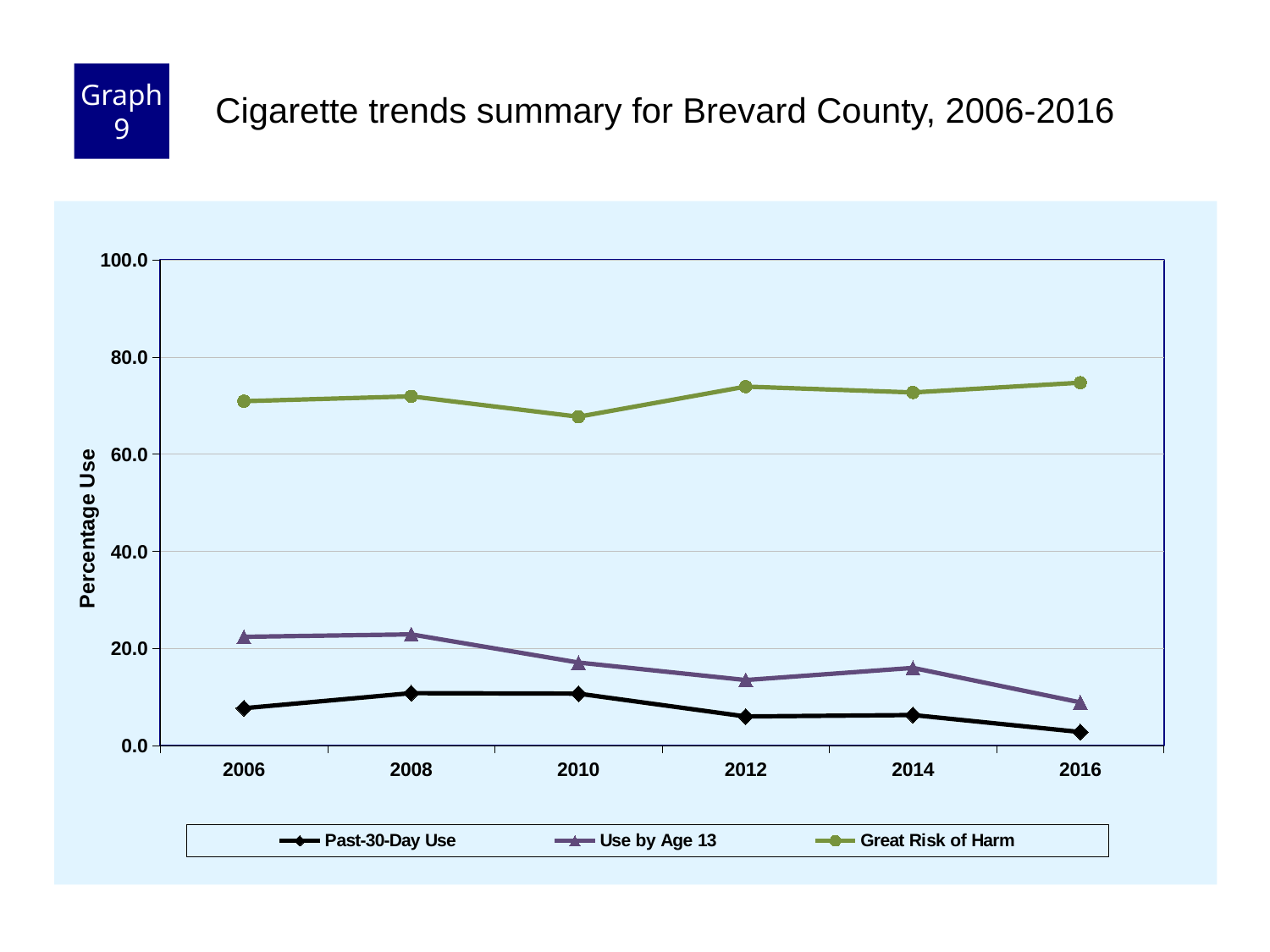
Is the value for Great Risk of Harm in 2010 greater or less than 80.0? less In which year is Great Risk of Harm at its lowest? 2010 What is the title of the chart? Cigarette trends summary for Brevard County, 2006-2016 Which is larger in 2012, Great Risk of Harm or Use by Age 13? Great Risk of Harm How many years are plotted along the x axis? 6 Is the value for Use by Age 13 in 2016 greater or less than 20.0? less In which year is Past-30-Day Use at its lowest? 2016 What kind of chart is shown on the slide? line chart What is the label on the y axis? Percentage Use Is the value for Use by Age 13 in 2006 greater or less than 20.0? greater How many series does the legend list? 3 Does Use by Age 13 rise or fall from 2008 to 2016? fall